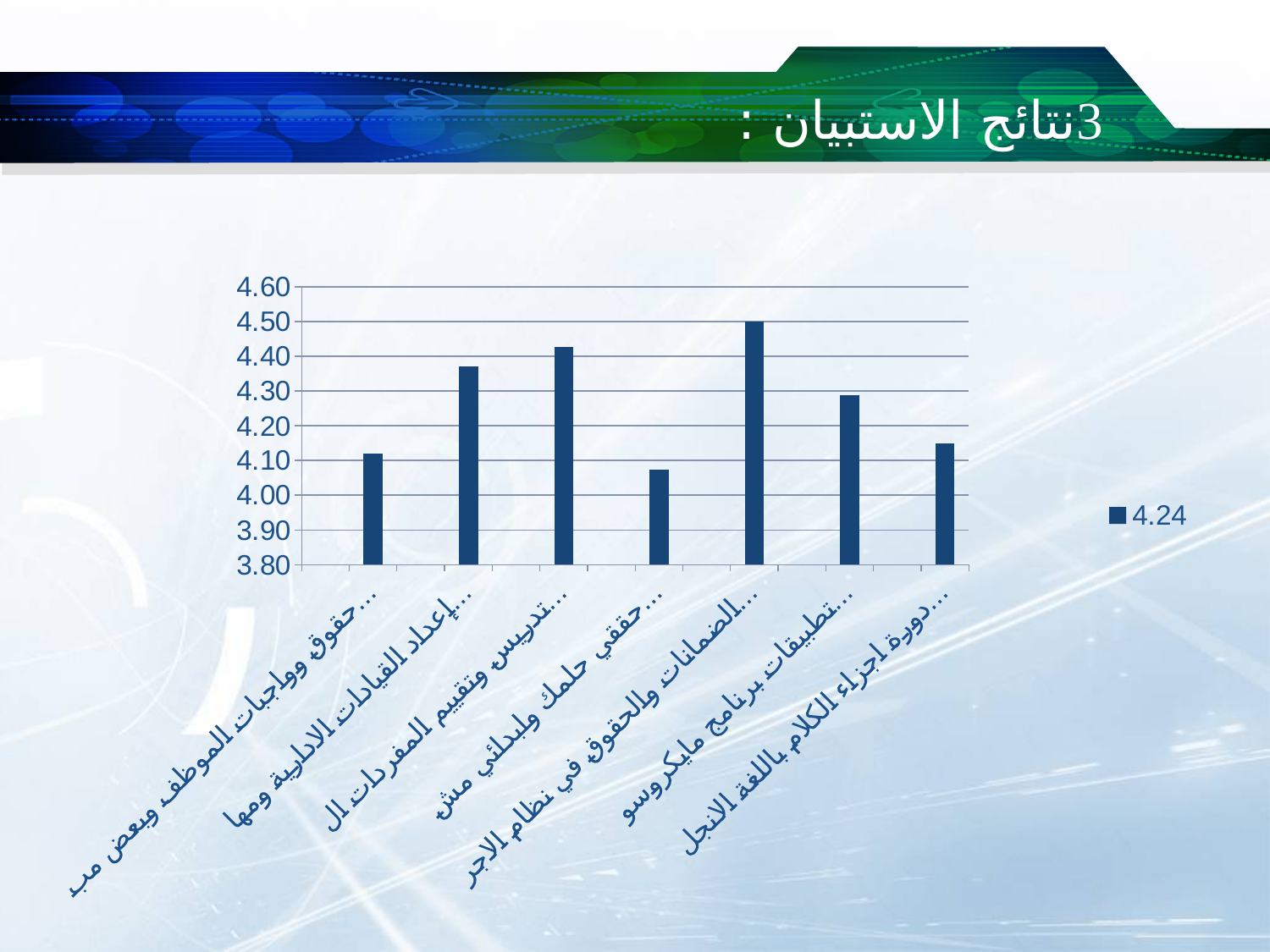
What is the lowest value shown on the vertical axis? 3.80 How many bars (categories) does the chart show? 7 Is the value of the second bar from the left (...إعداد القيادات الادارية) greater or less than 4.30? greater Which bar is the highest in the chart? the fifth bar from the left (...الضمانات والحقوق في نظام الاجر) How many series does the legend list? 1 Is the value of the first bar from the left (...حقوق وواجبات الموظف) greater or less than 4.20? less What is the legend entry shown next to the chart? 4.24 Which is larger: the second bar from the left (...إعداد القيادات الادارية) or the sixth bar from the left (...تطبيقات برنامج مايكروسو)? the second bar (...إعداد القيادات الادارية) Is the value of the seventh bar from the left (...دورة اجزاء الكلام باللغة الانجل) greater or less than 4.20? less What kind of chart is shown on the slide? bar chart Which bar is the lowest in the chart? the fourth bar from the left (...حققي حلمك وابدئي مش)